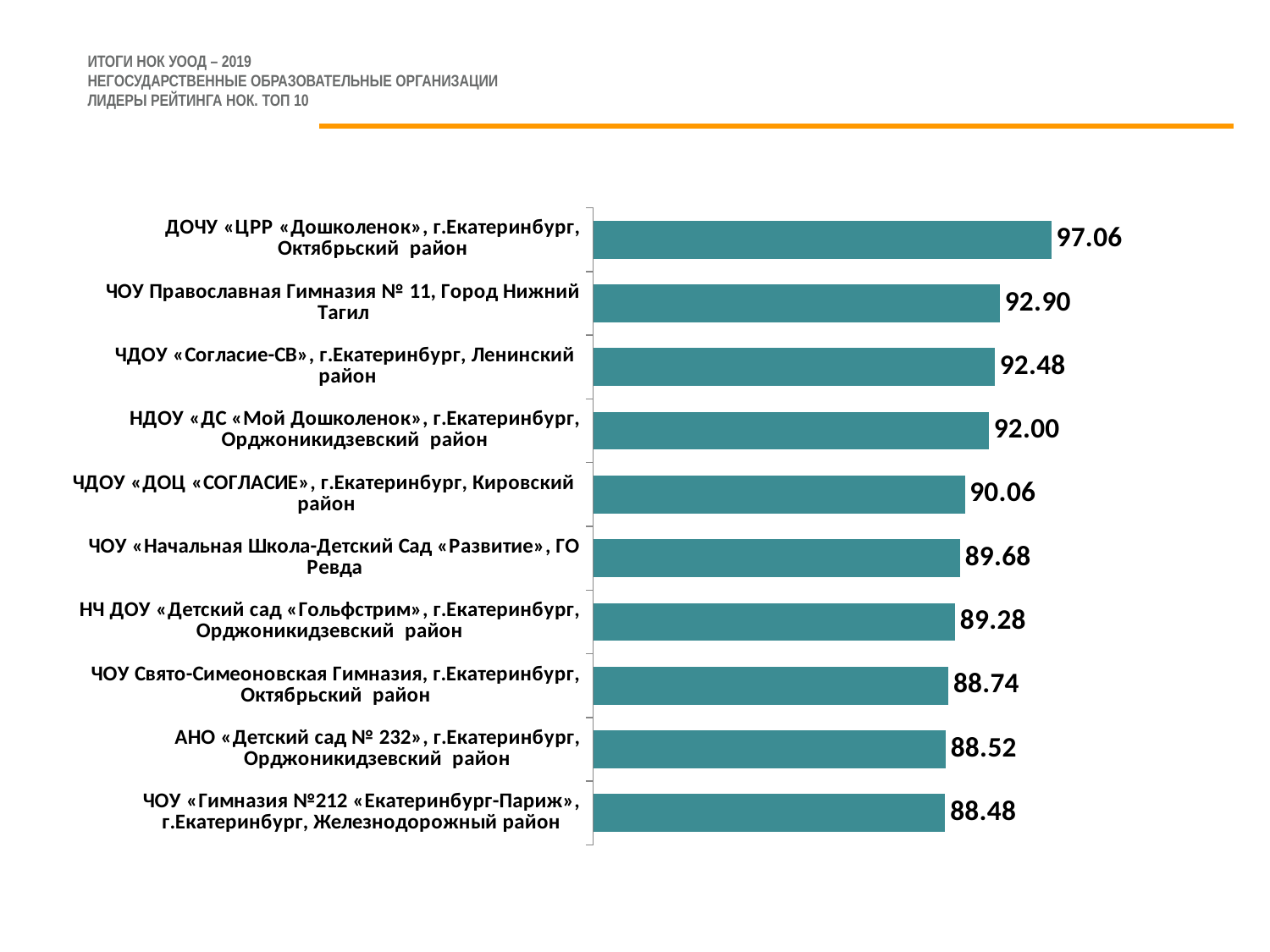
What is the value for ЧОУ Православная Гимназия № 11, Город Нижний Тагил? 92.90 Which organisation has the highest value? ДОЧУ «ЦРР «Дошколенок», г.Екатеринбург, Октябрьский район What is the difference between the values for ЧДОУ «Согласие-СВ» and НДОУ «ДС «Мой Дошколенок»? 0.48 What is the difference between the values for ДОЧУ «ЦРР «Дошколенок» and ЧОУ «Гимназия №212 «Екатеринбург-Париж»? 8.58 How many organisations are shown in the chart? 10 What is the value for ДОЧУ «ЦРР «Дошколенок», г.Екатеринбург, Октябрьский район? 97.06 What kind of chart is shown on the slide? Bar chart What is the value for ЧОУ «Начальная Школа-Детский Сад «Развитие», ГО Ревда? 89.68 Which has a larger value: ЧДОУ «ДОЦ «СОГЛАСИЕ», г.Екатеринбург, Кировский район or НЧ ДОУ «Детский сад «Гольфстрим», г.Екатеринбург, Орджоникидзевский район? ЧДОУ «ДОЦ «СОГЛАСИЕ», г.Екатеринбург, Кировский район Which organisation has the lowest value? ЧОУ «Гимназия №212 «Екатеринбург-Париж», г.Екатеринбург, Железнодорожный район Do the values increase or decrease going from the top bar to the bottom bar? Decrease What is the value for АНО «Детский сад № 232», г.Екатеринбург, Орджоникидзевский район? 88.52